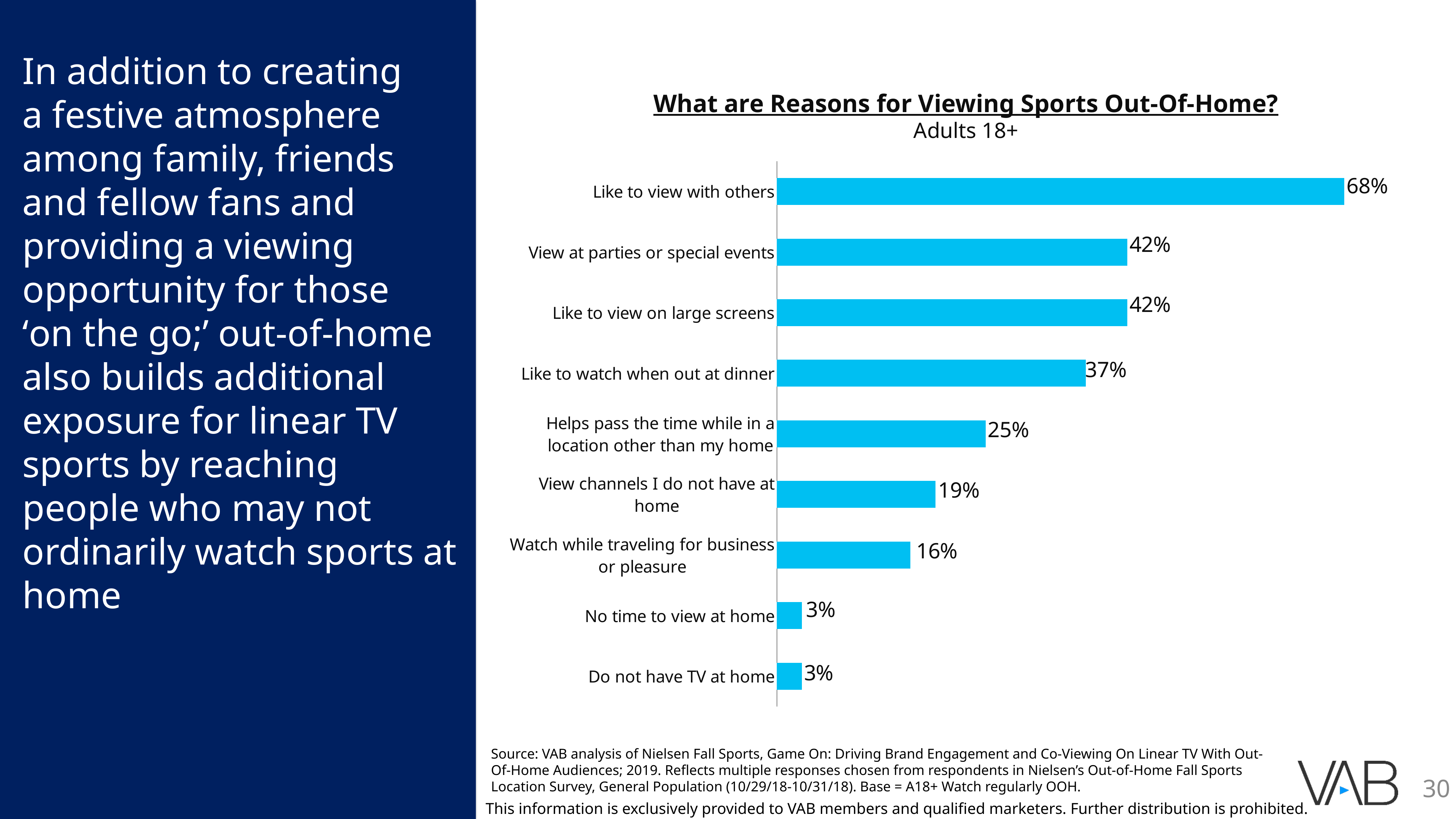
What is the title of the chart? What are Reasons for Viewing Sports Out-Of-Home? What is the value for 'View channels I do not have at home'? 19% What is the difference between 'Like to view with others' and 'View at parties or special events'? 26% What is the value for 'Like to watch when out at dinner'? 37% What percentage of adults 18+ cite 'Like to view with others' as a reason for viewing sports out-of-home? 68% What audience group does the chart subtitle indicate? Adults 18+ What kind of chart is shown on the slide? Bar chart Which reason has the highest percentage? Like to view with others What is the difference between 'Helps pass the time while in a location other than my home' and 'View channels I do not have at home'? 6% What is the value for 'Watch while traveling for business or pleasure'? 16% Which is larger: 'Like to watch when out at dinner' or 'Helps pass the time while in a location other than my home'? Like to watch when out at dinner How many reasons are shown in the chart? 9